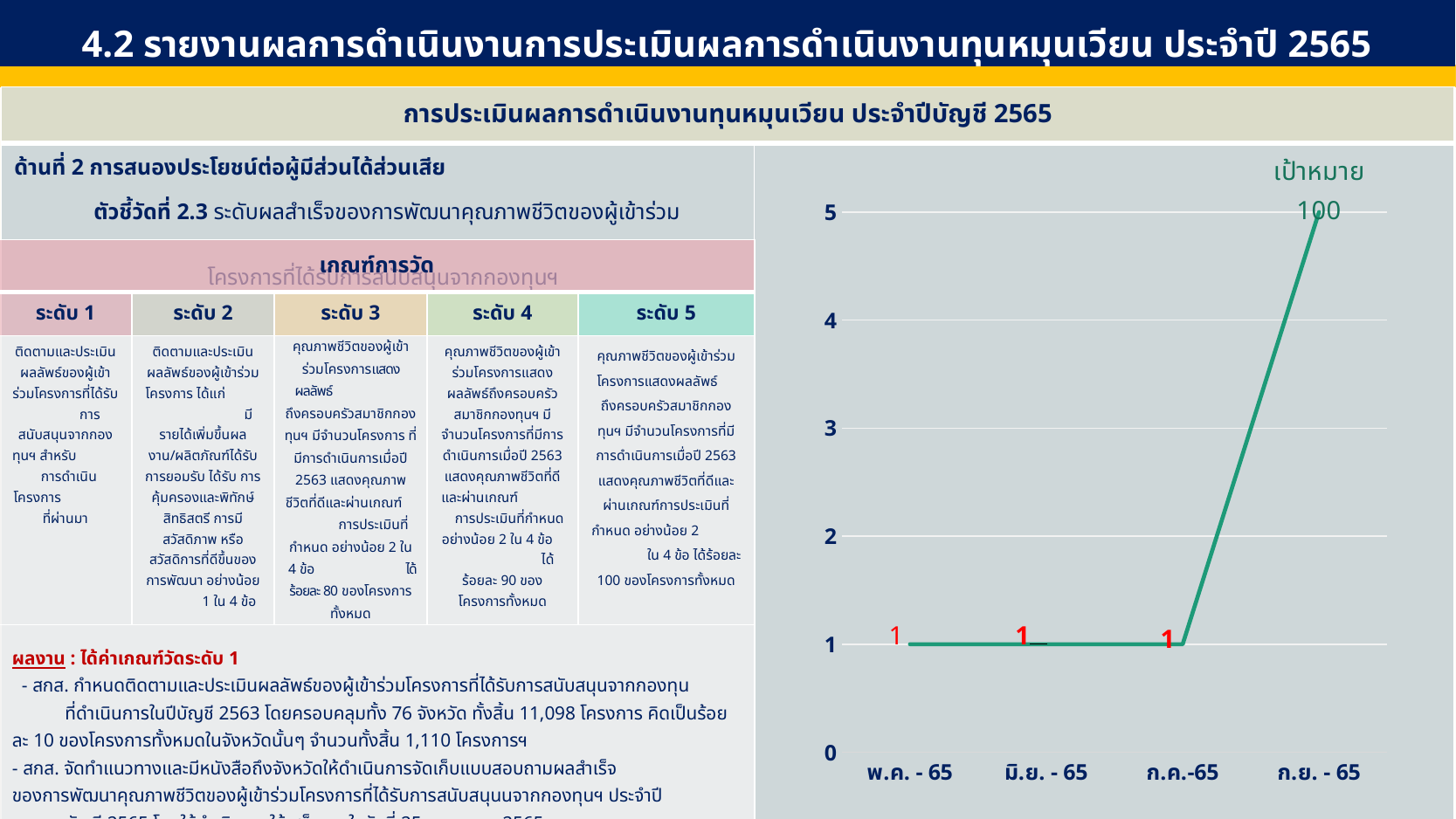
What is the value plotted for พ.ค. - 65? 1 Which is larger, the value for ก.ย. - 65 or the value for พ.ค. - 65? ก.ย. - 65 Is the value for ก.ค.-65 greater or less than 2? less Do the values rise or fall from ก.ค.-65 to ก.ย. - 65? rise What is the value plotted for ก.ค.-65? 1 How many categories are shown on the x axis of the chart? 4 Is the value for ก.ย. - 65 greater or less than 4? greater What colour is the line in the chart? green What word is printed above the last point of the line in the top right of the chart? เป้าหมาย Which category has the highest value on the chart? ก.ย. - 65 What kind of chart is shown on the right side of the slide? line chart What is the value plotted for มิ.ย. - 65? 1